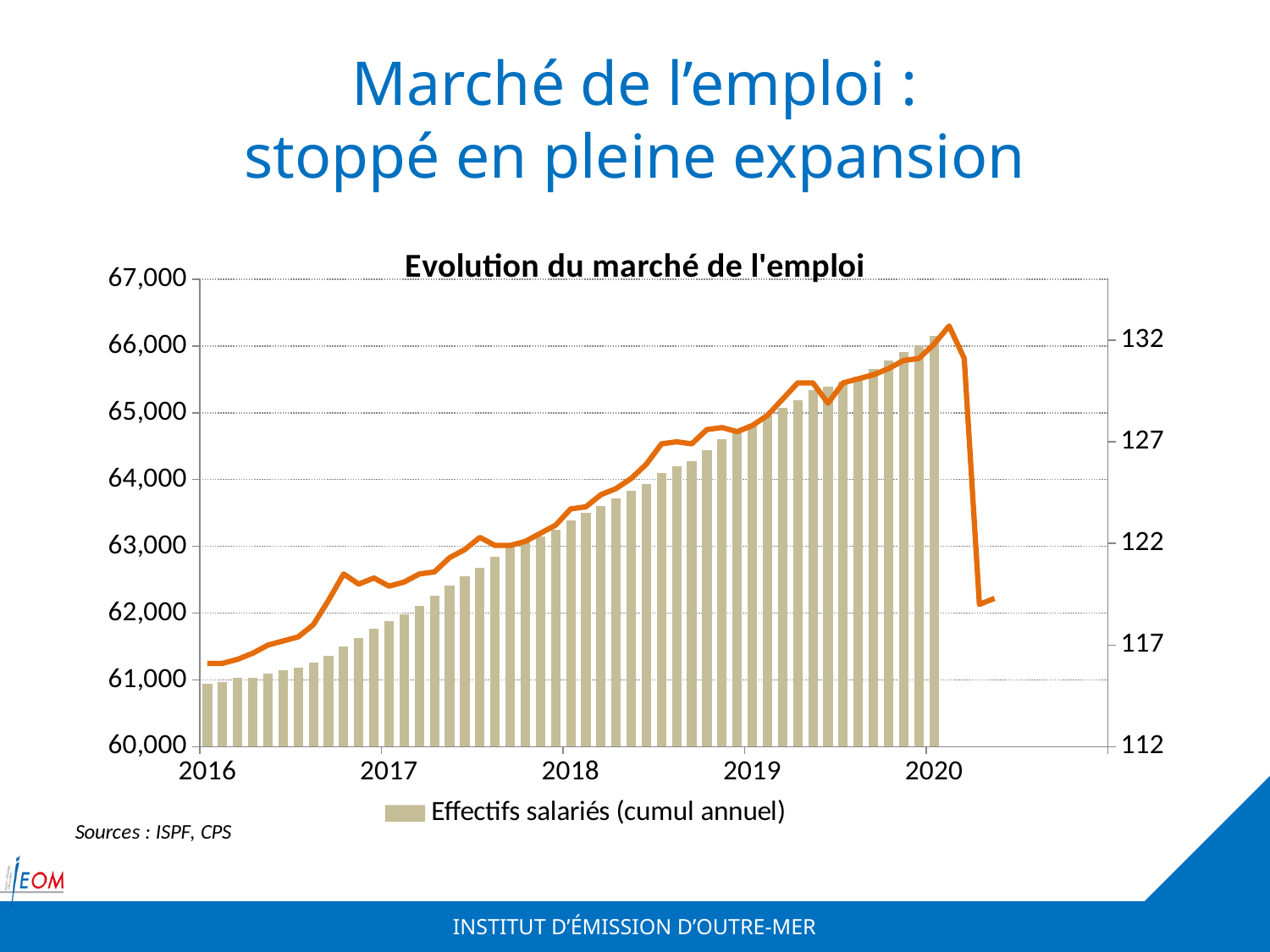
Is the bar value for Effectifs salariés at the 2019 tick greater or less than 64,000? greater What series name does the legend show for the bars? Effectifs salariés (cumul annuel) Does the orange line rise or fall after its peak in 2020? Fall Which year on the x axis has the lowest bar for Effectifs salariés (cumul annuel)? 2016 Is the value of the orange line at its peak in 2020 greater or less than 132 on the right axis? greater What is the title of the chart? Evolution du marché de l'emploi Is the bar value for Effectifs salariés at the 2018 tick greater or less than 63,000? greater How many series does the legend list? 1 Do the bars for Effectifs salariés (cumul annuel) rise or fall from 2016 to 2020? Rise What kind of chart is shown on the slide? A bar chart combined with a line